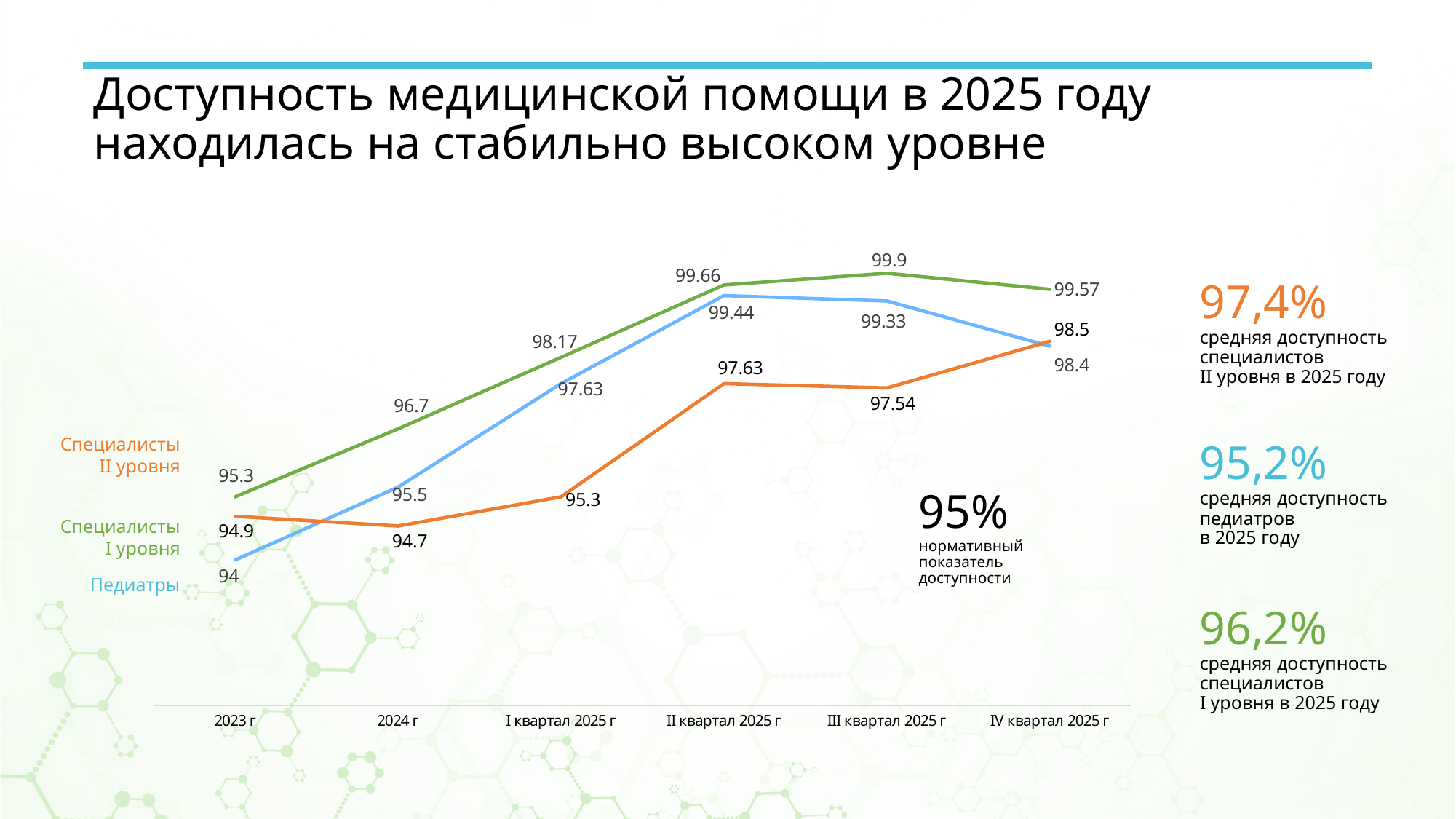
In which period is the value for Педиатры lowest? 2023 г How many points along the x axis does the chart have? 6 Which is larger in II квартал 2025 г: the value for Педиатры or the value for Специалисты II уровня? Педиатры What is the value for Специалисты II уровня in IV квартал 2025 г? 98.5 What is the value for Специалисты I уровня in III квартал 2025 г? 99.9 Does the value for Специалисты I уровня rise or fall from 2023 г to II квартал 2025 г? rise What is the difference between the Специалисты I уровня value and the Специалисты II уровня value in 2024 г? 2 In which period is the value for Специалисты I уровня highest? III квартал 2025 г What kind of chart is shown on the slide? line chart What value does the dashed horizontal line labelled нормативный показатель доступности mark? 95% What is the value for Педиатры in 2023 г? 94 How many series does the chart show? 3